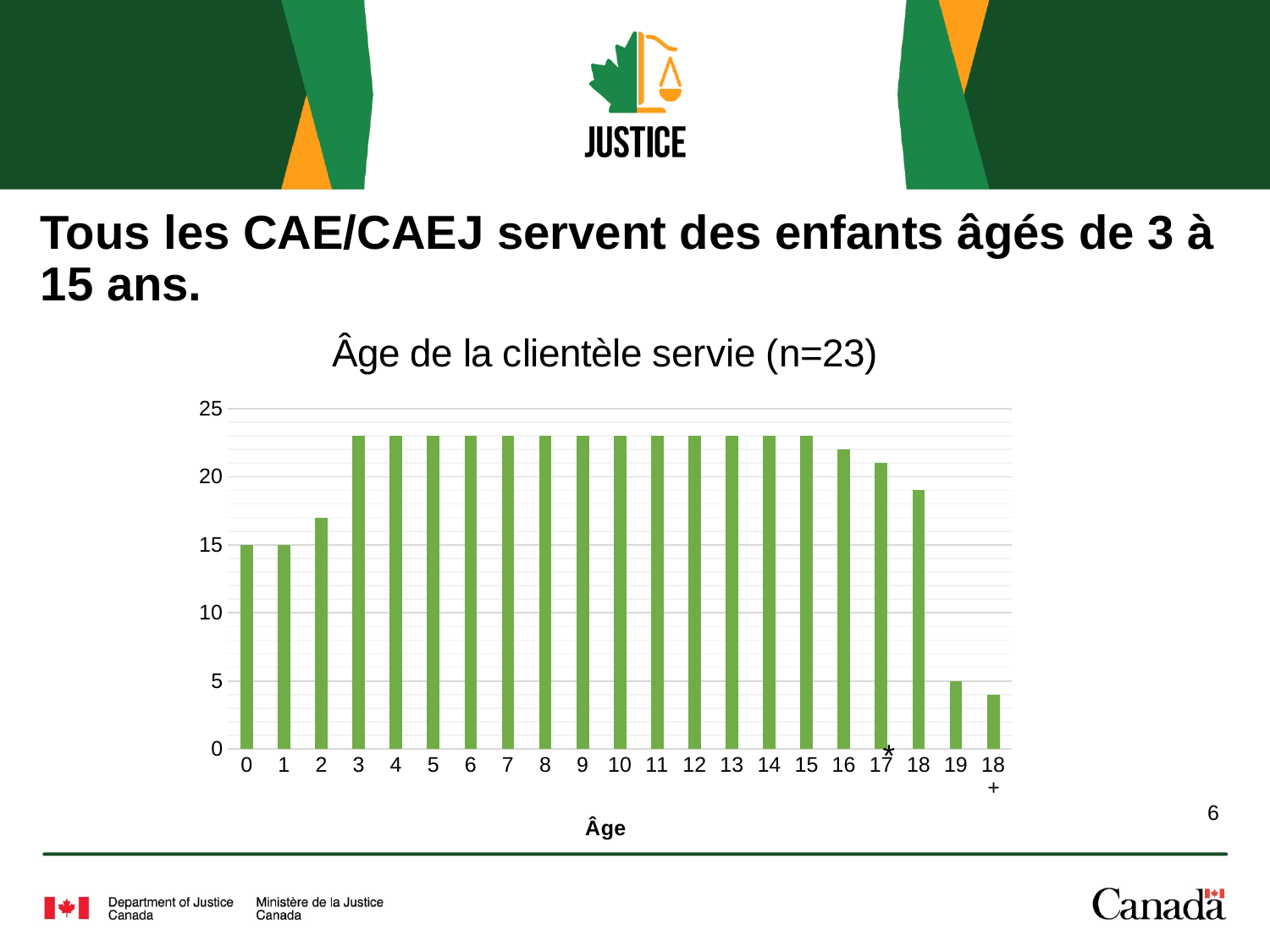
Which is larger, the value for age 16 or the value for age 18? age 16 What is the value for age 0? 15 What kind of chart is shown on the slide? bar chart Is the value for age 3 greater or less than 20? greater What is the label of the x axis? Âge Is the value for age 18 greater or less than 20? less Which age category has the lowest value? 18+ What is the value for age 19? 5 Is the value for age 2 greater or less than 15? greater What is the title of the chart? Âge de la clientèle servie (n=23) How many age categories are shown on the x axis? 21 Do the values rise or fall from age 16 to age 19? fall